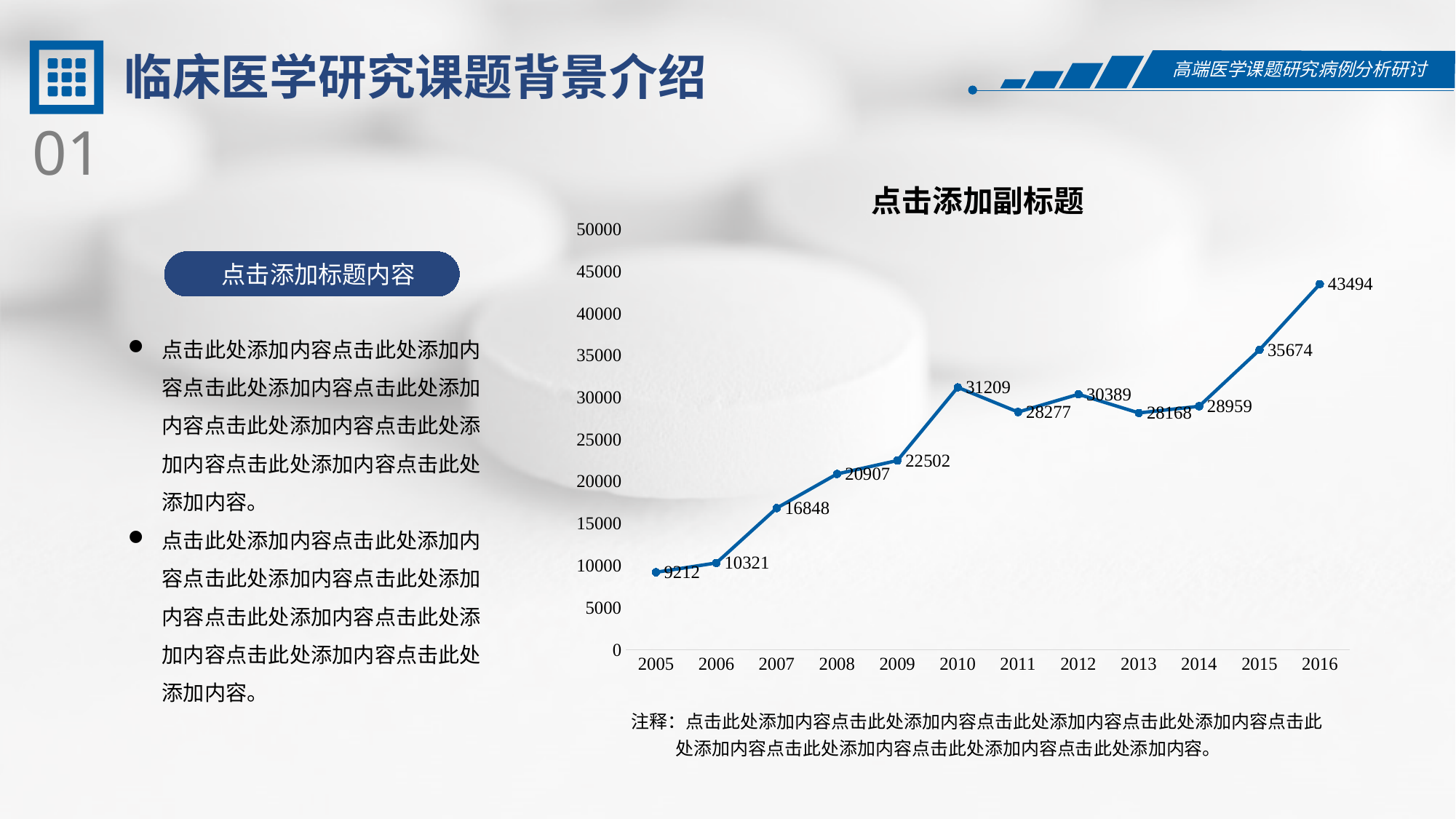
What is the title of the chart? 点击添加副标题 What is the difference between the values for 2010 and 2009? 8707 Is the value for 2008 greater or less than 20000? greater What is the value for 2010? 31209 What is the value for 2016? 43494 Which year has the highest value? 2016 What is the difference between the values for 2016 and 2015? 7820 How many years are plotted on the x axis? 12 Which year has the lowest value? 2005 What kind of chart is shown on the slide? line chart Which is larger, the value for 2011 or the value for 2012? 2012 What is the value for 2005? 9212